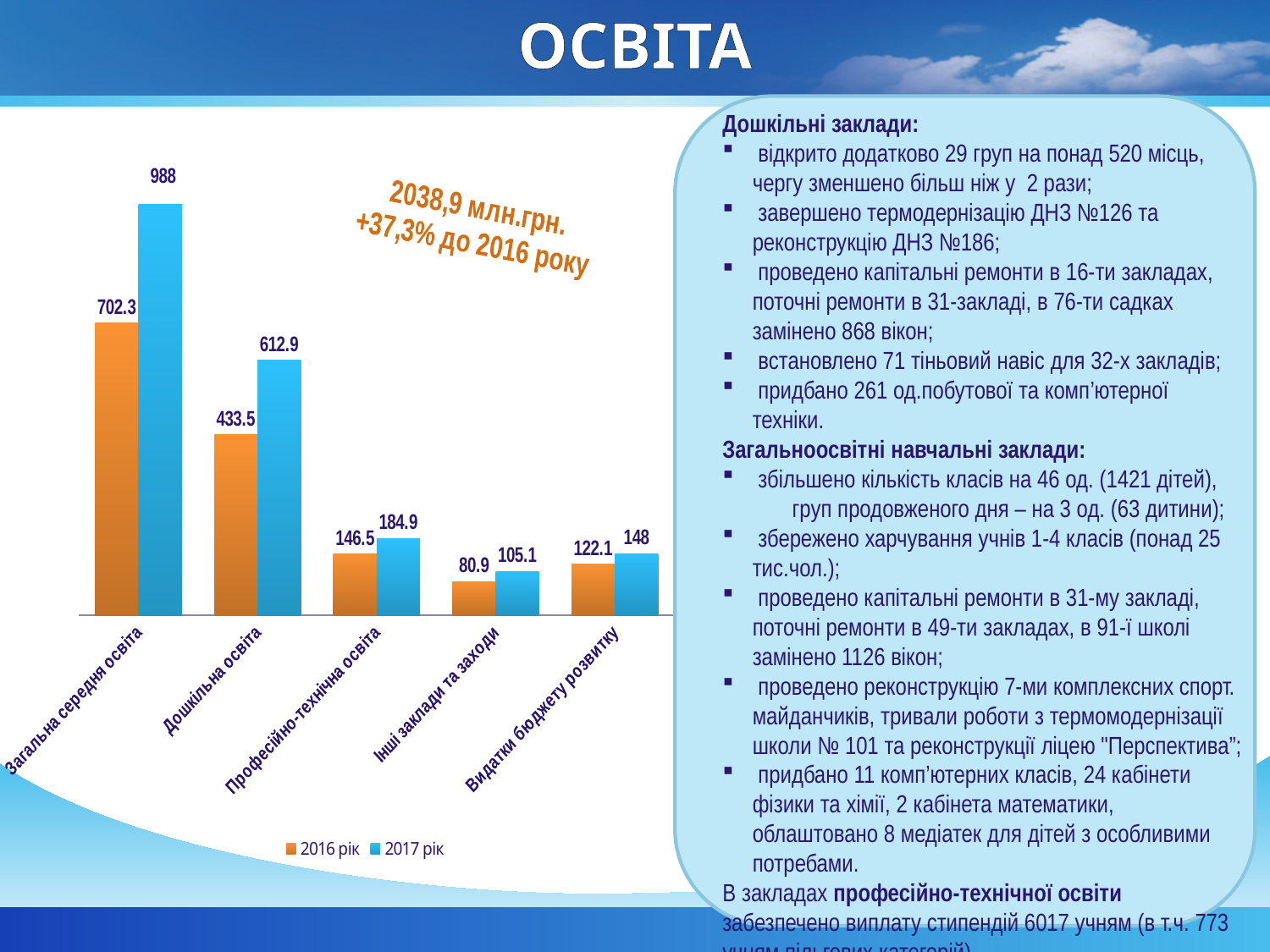
What is the value for Інші заклади та заходи in the 2017 рік series? 105.1 Which category has the highest value in the 2017 рік series? Загальна середня освіта Which is larger for Дошкільна освіта: the 2016 рік value or the 2017 рік value? 2017 рік Which category has the lowest value in the 2016 рік series? Інші заклади та заходи How many categories are shown on the x axis of the chart? 5 What is the value for Дошкільна освіта in the 2016 рік series? 433.5 What is the value for Видатки бюджету розвитку in the 2016 рік series? 122.1 How many series does the chart legend list? 2 What is the difference between the 2017 рік and 2016 рік values for Професійно-технічна освіта? 38.4 What is the value for Загальна середня освіта in the 2017 рік series? 988 What total amount and percentage change are written in the annotation on the chart? 2038,9 млн.грн. +37,3% до 2016 року What kind of chart is shown on the slide? Bar chart